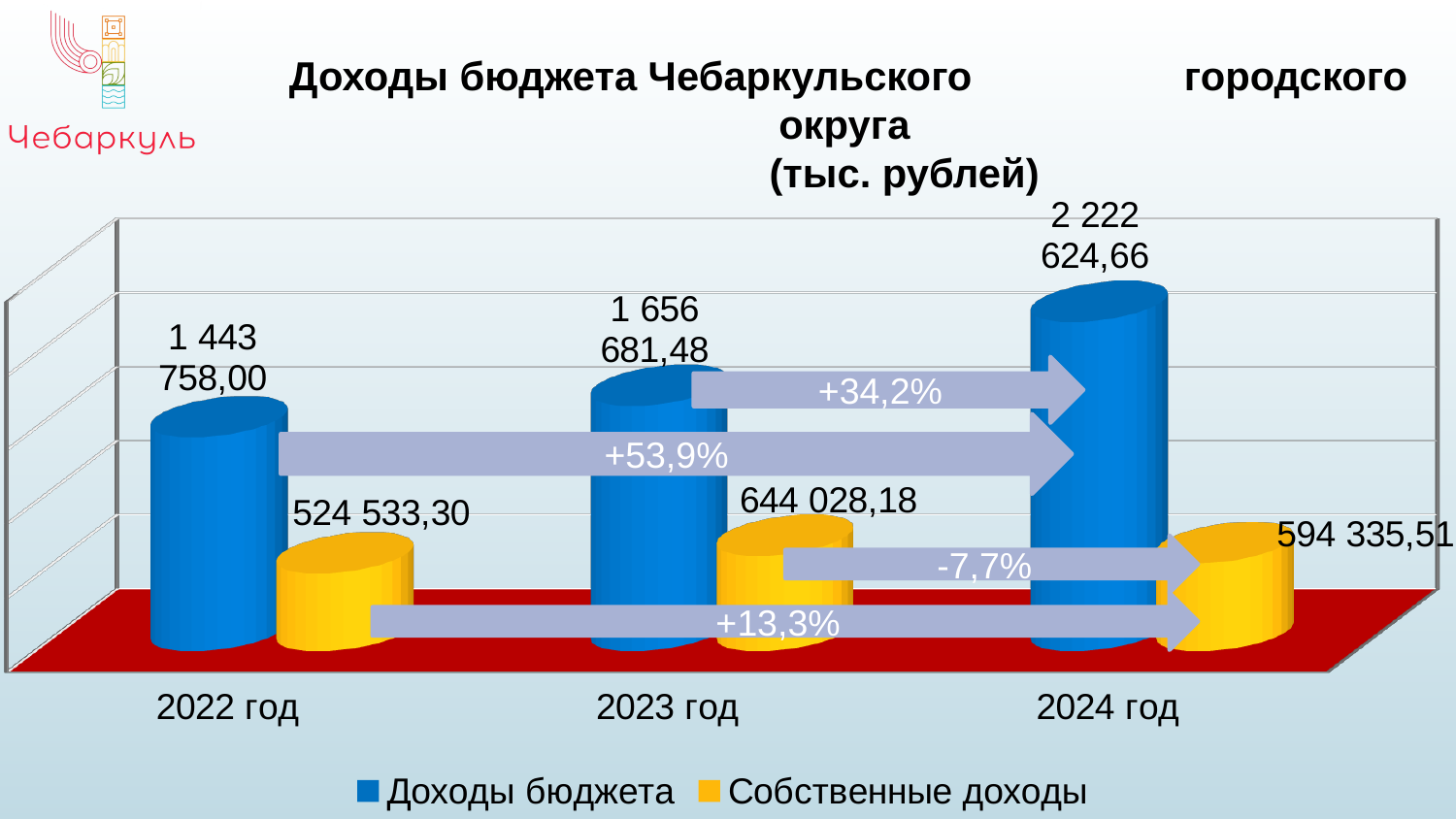
What is the value of Доходы бюджета for 2022 год? 1 443 758,00 How many years are shown on the x axis? 3 What is the value of Доходы бюджета for 2024 год? 2 222 624,66 What is the value of Собственные доходы for 2023 год? 644 028,18 In which year is Собственные доходы the lowest? 2022 год Which is larger: Собственные доходы in 2023 год or in 2024 год? 2023 год What is the value of Собственные доходы for 2024 год? 594 335,51 What is the difference between Собственные доходы in 2023 год and 2022 год? 119 494,88 In which year is Доходы бюджета the highest? 2024 год What kind of chart is shown on the slide? Bar chart How many series does the legend list? 2 Does Доходы бюджета rise or fall from 2022 год to 2024 год? Rise